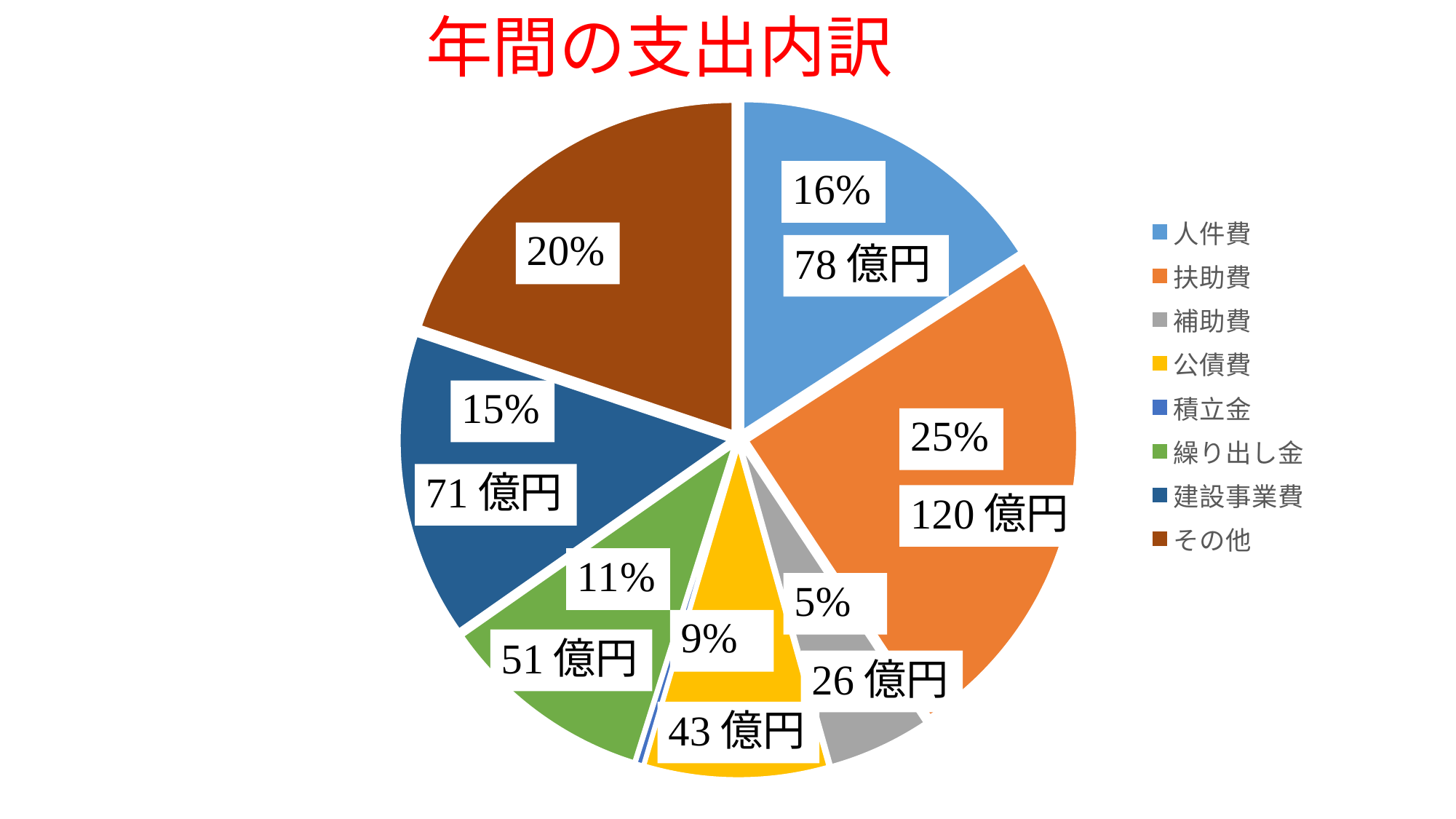
What kind of chart is shown on the slide? pie chart What share of the pie does 繰り出し金 account for? 11% What is the difference in value between 扶助費 and 人件費? 42 億円 Which category has the smallest slice of the pie? 積立金 Which category has the largest slice of the pie? 扶助費 What share of the pie does 扶助費 account for? 25% What is the value shown for 建設事業費? 71 億円 What is the title of the chart? 年間の支出内訳 What is the value shown for 人件費? 78 億円 Which is larger, the value for 公債費 or the value for 補助費? 公債費 How many categories does the legend list? 8 What share of the pie does その他 account for? 20%